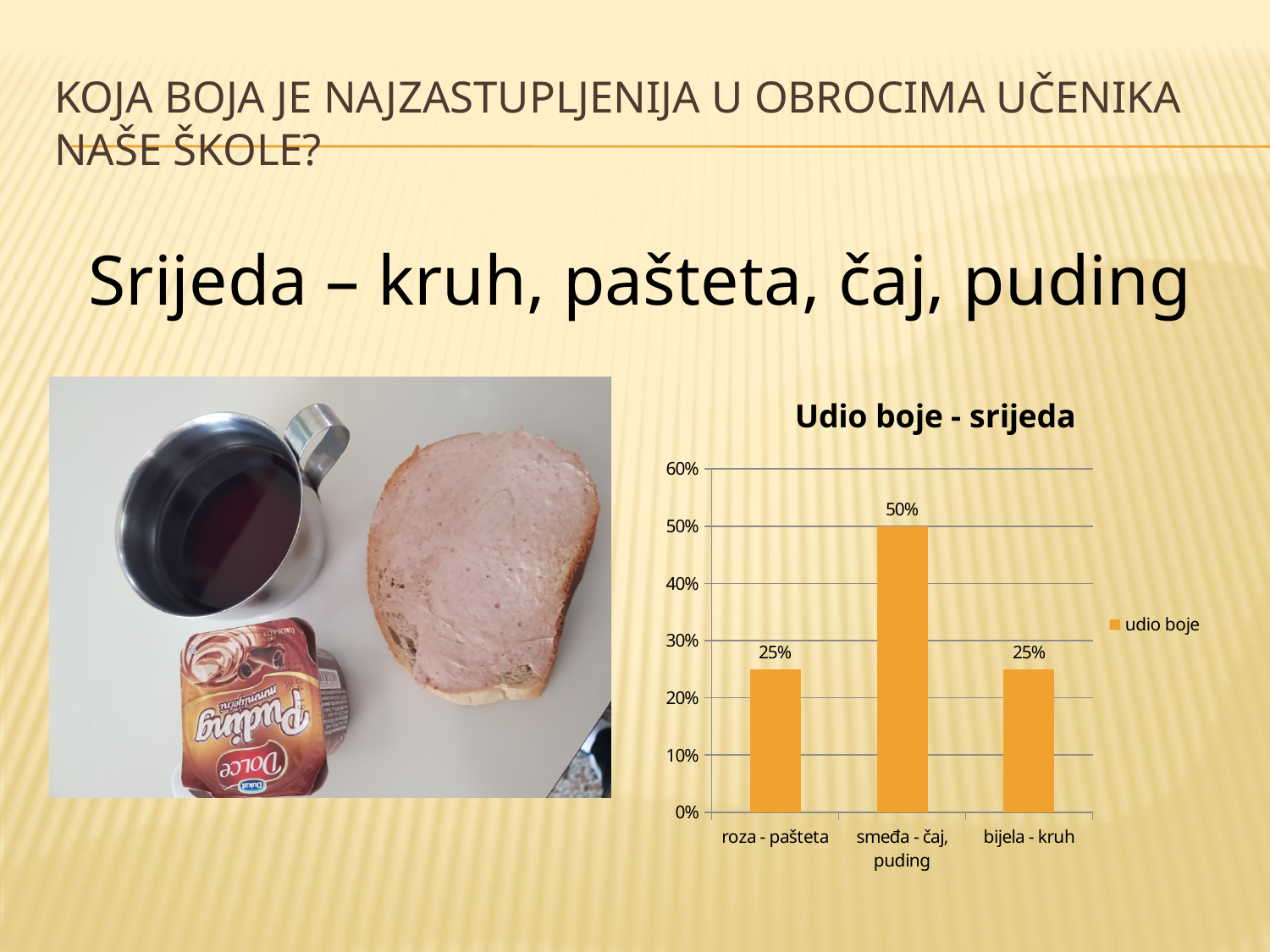
Is the value for "roza - pašteta" greater or less than 30%? less What is the value for "roza - pašteta" in the chart? 25% Which is larger, the value for "smeđa - čaj, puding" or the value for "bijela - kruh"? smeđa - čaj, puding What is the title of the chart? Udio boje - srijeda What is the value for "smeđa - čaj, puding" in the chart? 50% What kind of chart is shown on the slide? bar chart What is the difference between the values for "smeđa - čaj, puding" and "roza - pašteta"? 25% Which category has the highest value in the chart? smeđa - čaj, puding Is the value for "smeđa - čaj, puding" greater or less than 40%? greater How many categories are shown in the chart? 3 How many series does the chart legend list? 1 What is the value for "bijela - kruh" in the chart? 25%